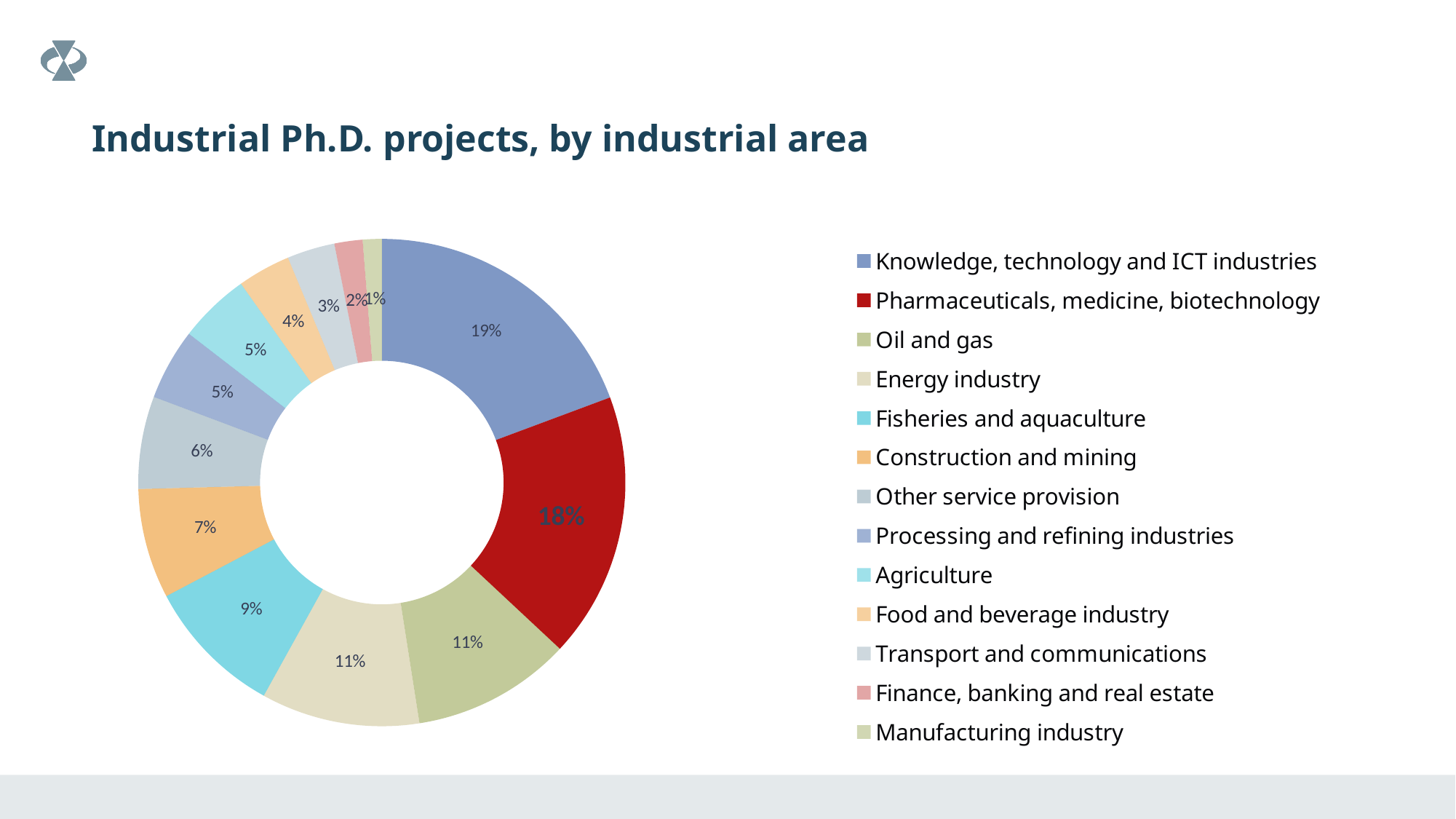
Which has a larger share: Other service provision or Food and beverage industry? Other service provision How many industrial areas are shown in the chart? 13 What is the value for Transport and communications? 3% What kind of chart is shown on the slide? Doughnut (pie) chart What is the title of the slide? Industrial Ph.D. projects, by industrial area What percentage is shown for Construction and mining? 7% Which industrial area has the smallest share of industrial Ph.D. projects? Manufacturing industry What percentage is shown for Pharmaceuticals, medicine, biotechnology? 18% What share of industrial Ph.D. projects is in Knowledge, technology and ICT industries? 19% What is the difference in percentage points between Knowledge, technology and ICT industries and Oil and gas? 8 Which industrial area has the largest share of industrial Ph.D. projects? Knowledge, technology and ICT industries What is the value for Fisheries and aquaculture? 9%